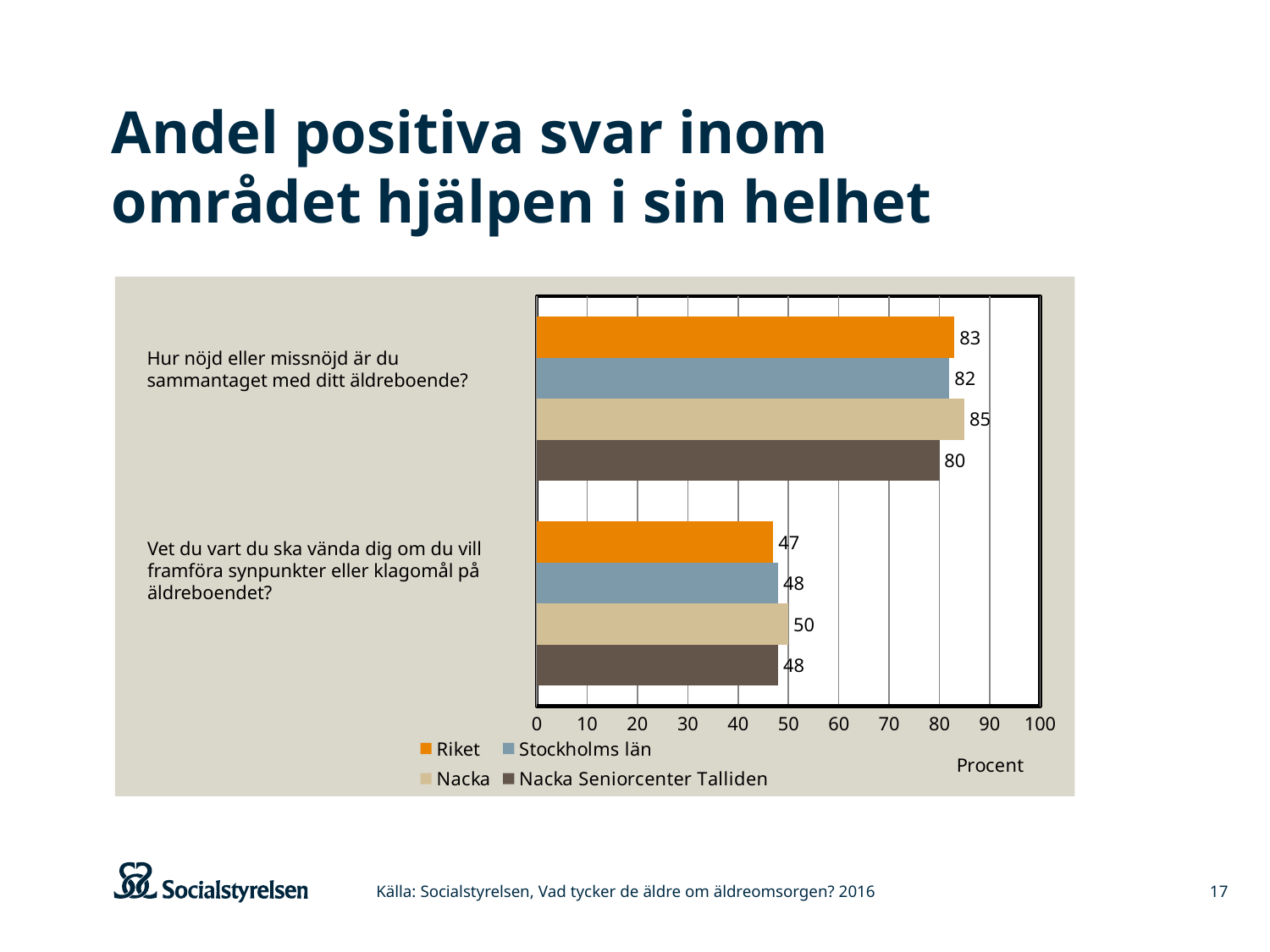
What is the difference between the Nacka value and the Nacka Seniorcenter Talliden value on the question "Hur nöjd eller missnöjd är du sammantaget med ditt äldreboende?"? 5 Which series has the lowest value on the question "Hur nöjd eller missnöjd är du sammantaget med ditt äldreboende?"? Nacka Seniorcenter Talliden Which series has the highest value on the question "Hur nöjd eller missnöjd är du sammantaget med ditt äldreboende?"? Nacka What is the value for Nacka on the question "Hur nöjd eller missnöjd är du sammantaget med ditt äldreboende?"? 85 What is the value for Nacka Seniorcenter Talliden on the question "Hur nöjd eller missnöjd är du sammantaget med ditt äldreboende?"? 80 What is the value for Stockholms län on the question "Vet du vart du ska vända dig om du vill framföra synpunkter eller klagomål på äldreboendet?"? 48 Which is larger: the Riket value or the Stockholms län value on the question "Hur nöjd eller missnöjd är du sammantaget med ditt äldreboende?"? Riket What is the difference between the Nacka value and the Riket value on the question "Vet du vart du ska vända dig om du vill framföra synpunkter eller klagomål på äldreboendet?"? 3 What kind of chart is shown on the slide? Bar chart What is the value for Riket on the question "Vet du vart du ska vända dig om du vill framföra synpunkter eller klagomål på äldreboendet?"? 47 Which series has the highest value on the question "Vet du vart du ska vända dig om du vill framföra synpunkter eller klagomål på äldreboendet?"? Nacka How many series does the legend list? 4